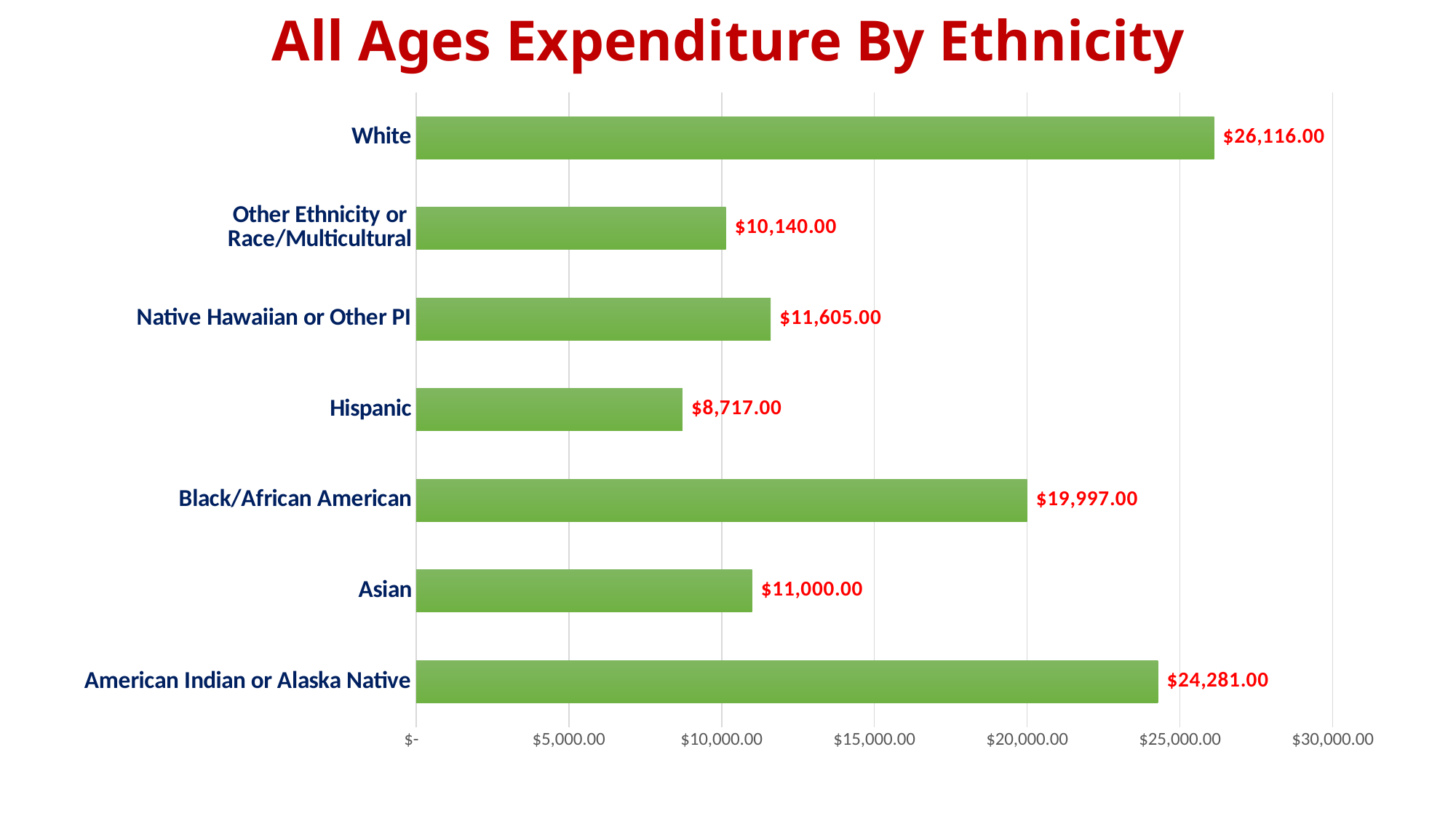
What is the title of the chart? All Ages Expenditure By Ethnicity What is the expenditure value for Black/African American? $19,997.00 Which ethnicity has the lowest expenditure? Hispanic What is the expenditure value for Hispanic? $8,717.00 What is the expenditure value for White? $26,116.00 What kind of chart is shown on the slide? Bar chart How many ethnicity categories are shown in the chart? 7 Which has a larger expenditure, Black/African American or Other Ethnicity or Race/Multicultural? Black/African American What is the expenditure value for American Indian or Alaska Native? $24,281.00 Which ethnicity has the highest expenditure? White What is the difference between the expenditure for White and for American Indian or Alaska Native? $1,835.00 What is the difference between the expenditure for Native Hawaiian or Other PI and for Asian? $605.00